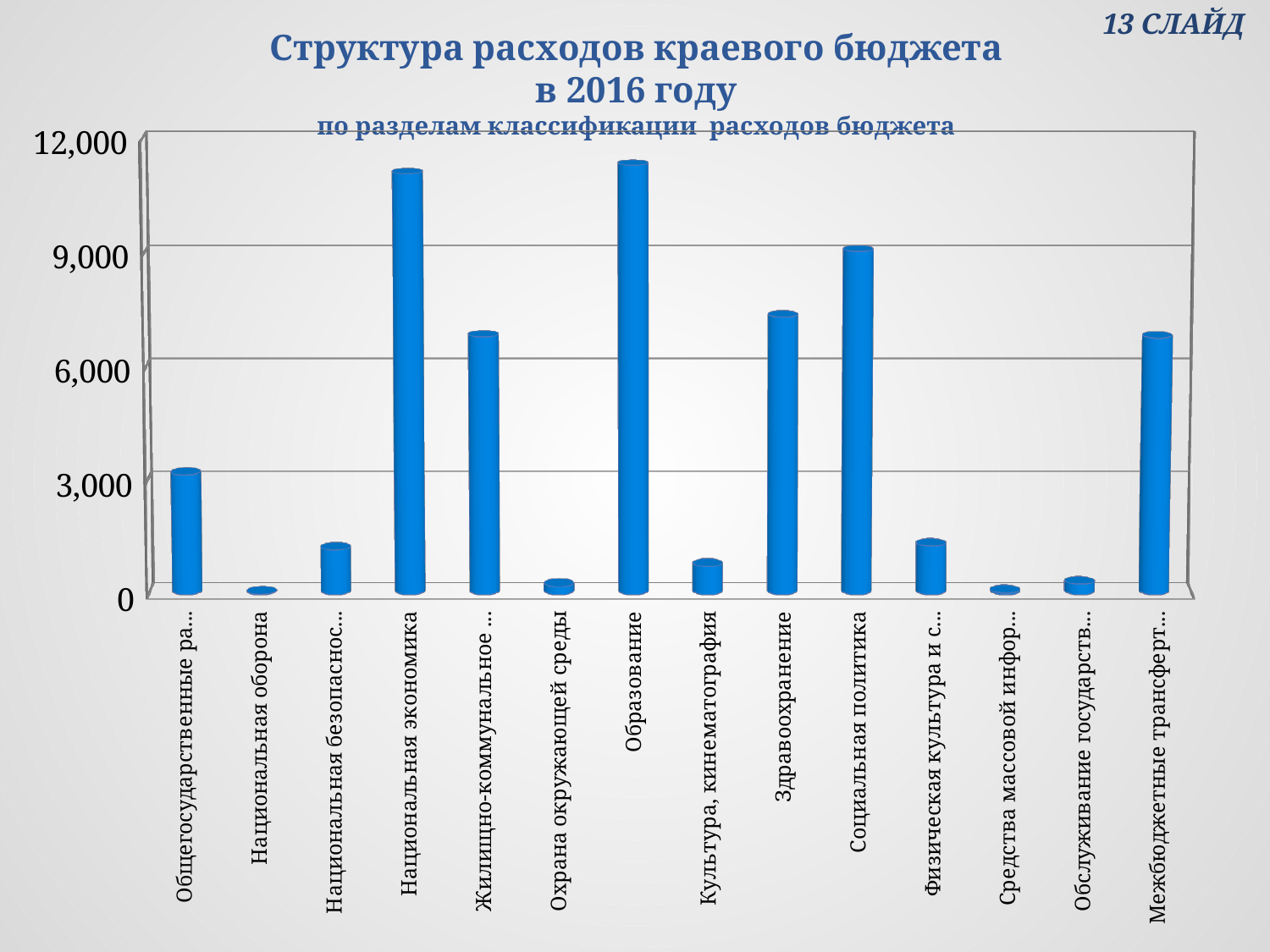
Is the value for Здравоохранение greater or less than 6,000? greater Is the value for Культура, кинематография greater or less than 3,000? less Is the value for Социальная политика greater or less than 6,000? greater Which category has the highest bar on the chart? Образование What kind of chart is shown on the slide? bar chart Which is larger, the value for Национальная экономика or the value for Охрана окружающей среды? Национальная экономика How many categories (budget sections) are plotted on the chart? 14 Which is larger, the value for Здравоохранение or the value for Социальная политика? Социальная политика What is the highest value shown on the vertical axis of the chart? 12,000 What year does the chart title say the budget expenditure structure refers to? 2016